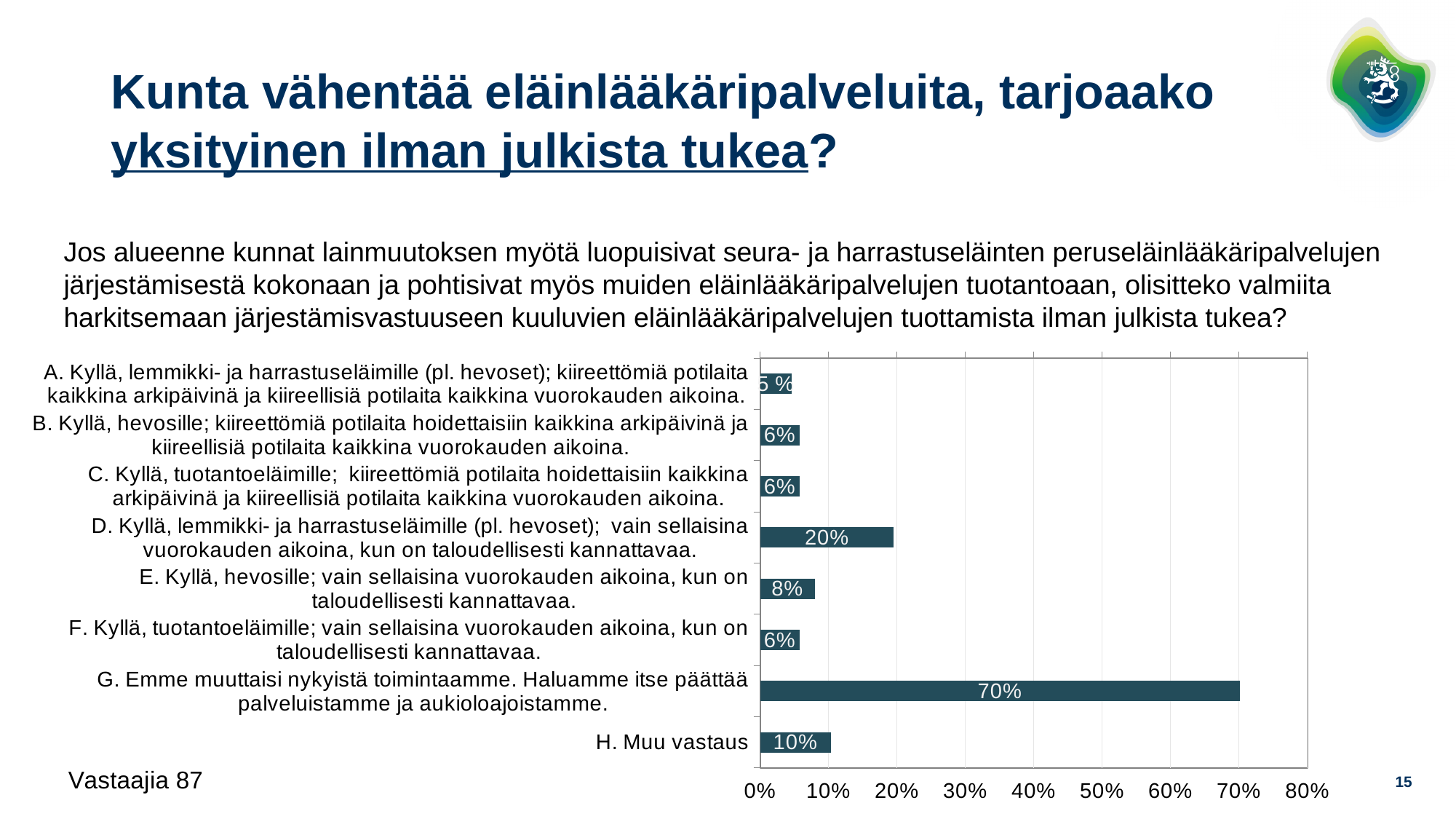
What kind of chart is shown on the slide? Bar chart Is the value for option A greater or less than 10%? less What is the value for option H (Muu vastaus)? 10% What is the difference between the values for option H and option E? 2% How many respondents (Vastaajia) are stated on the slide? 87 Which option has the highest value? G. Emme muuttaisi nykyistä toimintaamme Which is larger, the value for option D or the value for option H? Option D What is the difference between the values for option G and option D? 50% What is the value for option G (Emme muuttaisi nykyistä toimintaamme)? 70% What is the value for option D (Kyllä, lemmikki- ja harrastuseläimille, vain sellaisina vuorokauden aikoina, kun on taloudellisesti kannattavaa)? 20% How many options (categories) are shown in the chart? 8 What is the value for option E (Kyllä, hevosille; vain sellaisina vuorokauden aikoina, kun on taloudellisesti kannattavaa)? 8%